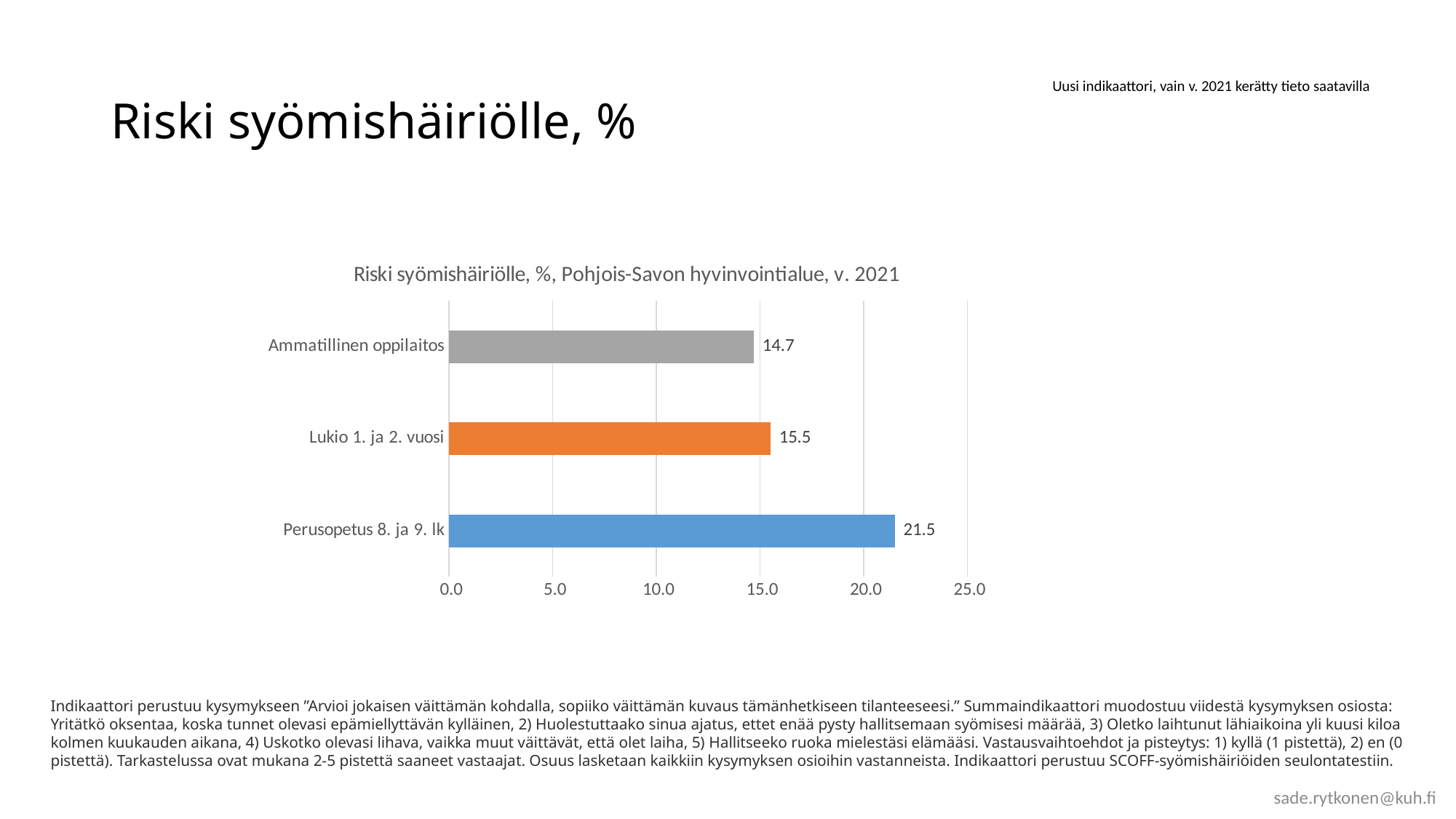
What is the value for Lukio 1. ja 2. vuosi? 15.5 Which category has the highest value? Perusopetus 8. ja 9. lk What is the difference between the values for Lukio 1. ja 2. vuosi and Ammatillinen oppilaitos? 0.8 What is the title of the chart? Riski syömishäiriölle, %, Pohjois-Savon hyvinvointialue, v. 2021 Is the value for Perusopetus 8. ja 9. lk greater or less than 20.0? greater Which category has the lowest value? Ammatillinen oppilaitos How many categories are shown in the chart? 3 What is the difference between the values for Perusopetus 8. ja 9. lk and Ammatillinen oppilaitos? 6.8 What is the value for Ammatillinen oppilaitos? 14.7 What kind of chart is shown on the slide? bar chart What is the value for Perusopetus 8. ja 9. lk? 21.5 Which is larger, the value for Perusopetus 8. ja 9. lk or the value for Lukio 1. ja 2. vuosi? Perusopetus 8. ja 9. lk